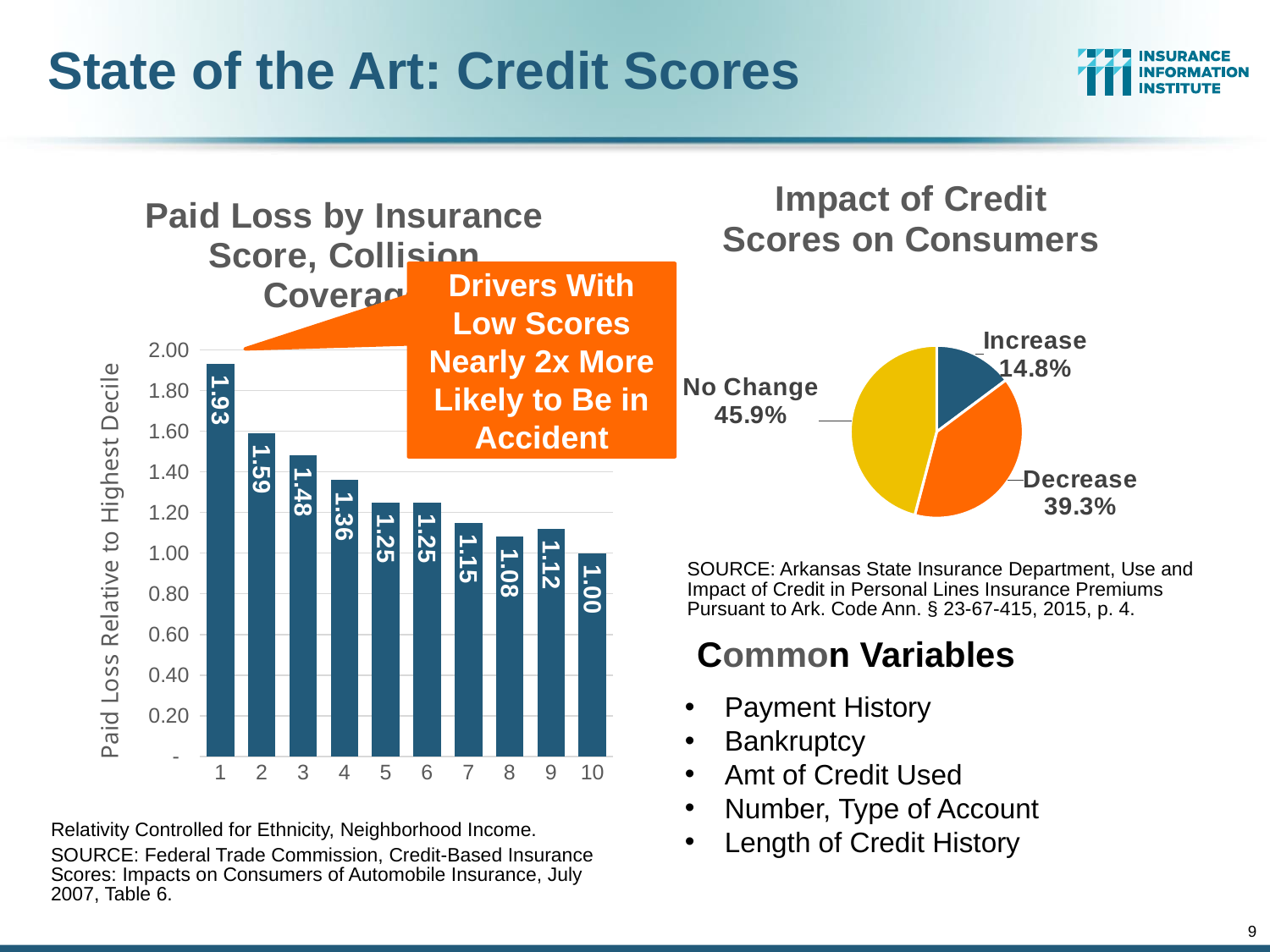
In the Paid Loss by Insurance Score chart, what is the paid loss value for decile 1? 1.93 In the Paid Loss by Insurance Score chart, do the values generally rise or fall from decile 1 to decile 10? Fall In the Paid Loss by Insurance Score chart, which decile has the lowest paid loss value? 10 In the Paid Loss by Insurance Score chart, what is the value for decile 4? 1.36 In the Paid Loss by Insurance Score chart, what is the difference between the values for decile 1 and decile 10? 0.93 In the Impact of Credit Scores on Consumers pie chart, which category has the largest share? No Change In the Impact of Credit Scores on Consumers pie chart, what is the difference between the No Change and Increase shares? 31.1% In the Impact of Credit Scores on Consumers pie chart, what share of consumers saw a decrease? 39.3% In the Paid Loss by Insurance Score chart, which has the larger value, decile 8 or decile 9? Decile 9 What type of chart is the Paid Loss by Insurance Score chart? Bar chart How many deciles are plotted in the Paid Loss by Insurance Score chart? 10 In the Paid Loss by Insurance Score chart, which decile has the highest paid loss value? 1